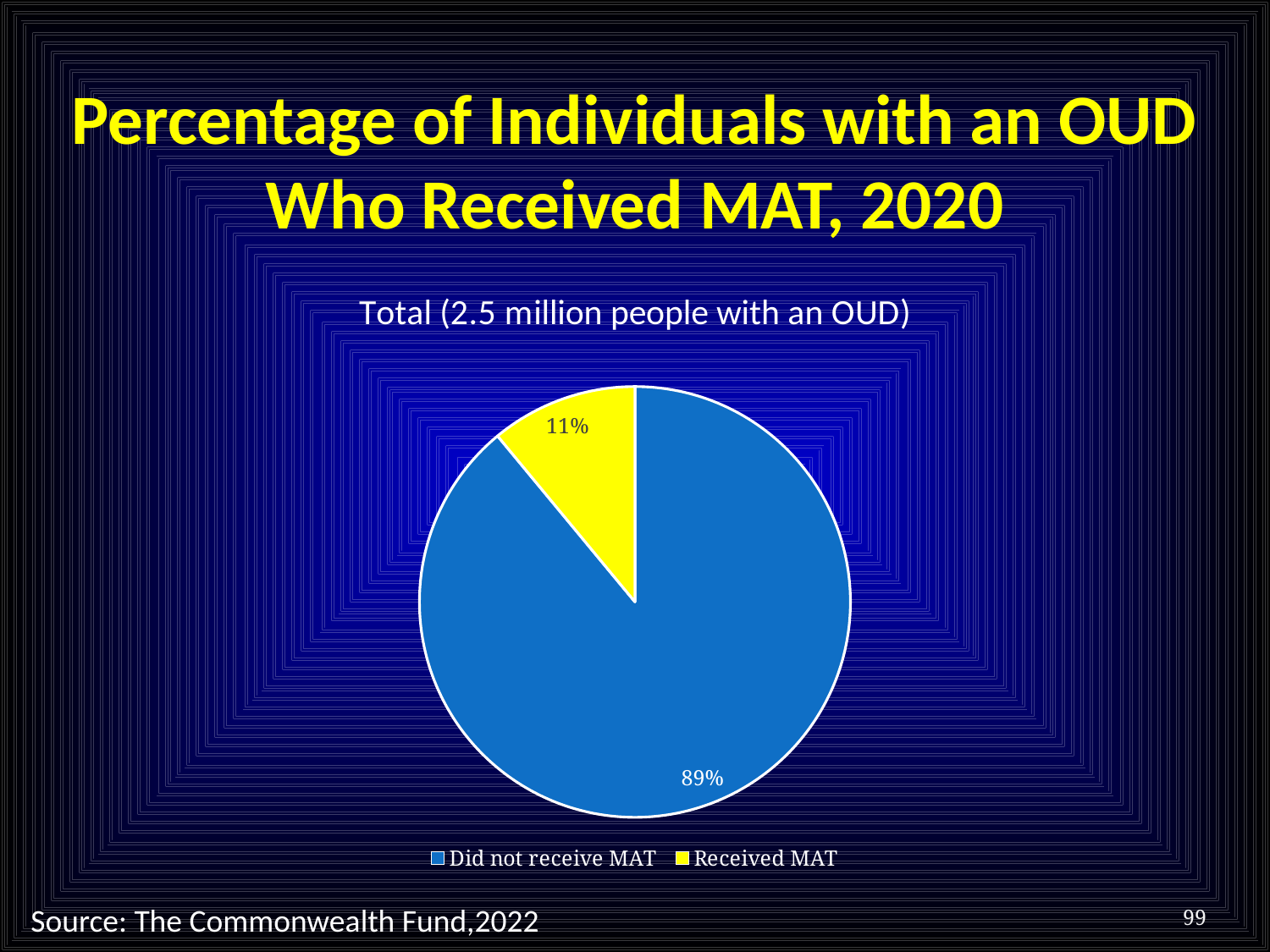
What share of the pie does the 'Received MAT' slice represent? 11% Which is larger: the share that received MAT or the share that did not receive MAT? Did not receive MAT Which slice of the pie is the largest? Did not receive MAT How many entries does the legend list? 2 What colour is the 'Received MAT' slice? Yellow What percentage of individuals with an OUD received MAT? 11% What kind of chart is shown on the slide? Pie chart What percentage of individuals with an OUD did not receive MAT? 89% What is the title shown directly above the pie chart? Total (2.5 million people with an OUD) What is the difference in percentage points between the 'Did not receive MAT' slice and the 'Received MAT' slice? 78 Which slice of the pie is the smallest? Received MAT How many slices does the pie chart have? 2